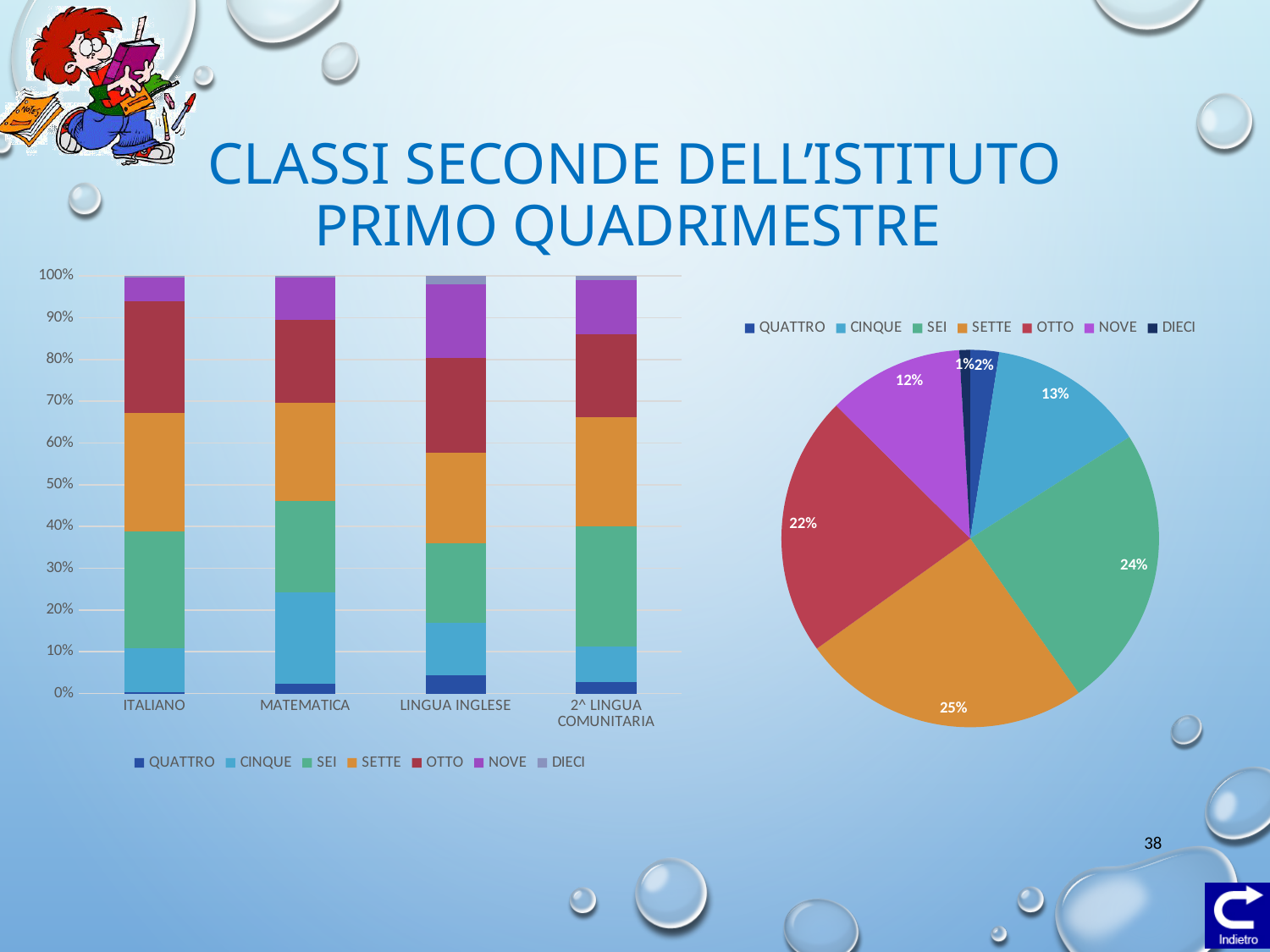
In the stacked bar chart on the left, which category has the largest CINQUE segment? MATEMATICA In the pie chart on the right, which grade has the largest slice? SETTE In the pie chart on the right, what percentage is shown for SETTE? 25% In the pie chart on the right, what percentage is shown for OTTO? 22% In the pie chart on the right, what percentage is shown for CINQUE? 13% In the pie chart on the right, what is the difference between the SETTE and SEI percentages? 1% How many series does the legend of the stacked bar chart on the left list? 7 What kind of chart is the chart on the left of the slide? Stacked bar chart How many categories are shown on the x axis of the stacked bar chart on the left? 4 In the pie chart on the right, what percentage is shown for SEI? 24% In the pie chart on the right, which grade has the smallest slice? DIECI In the pie chart on the right, which is larger, the OTTO slice or the NOVE slice? OTTO